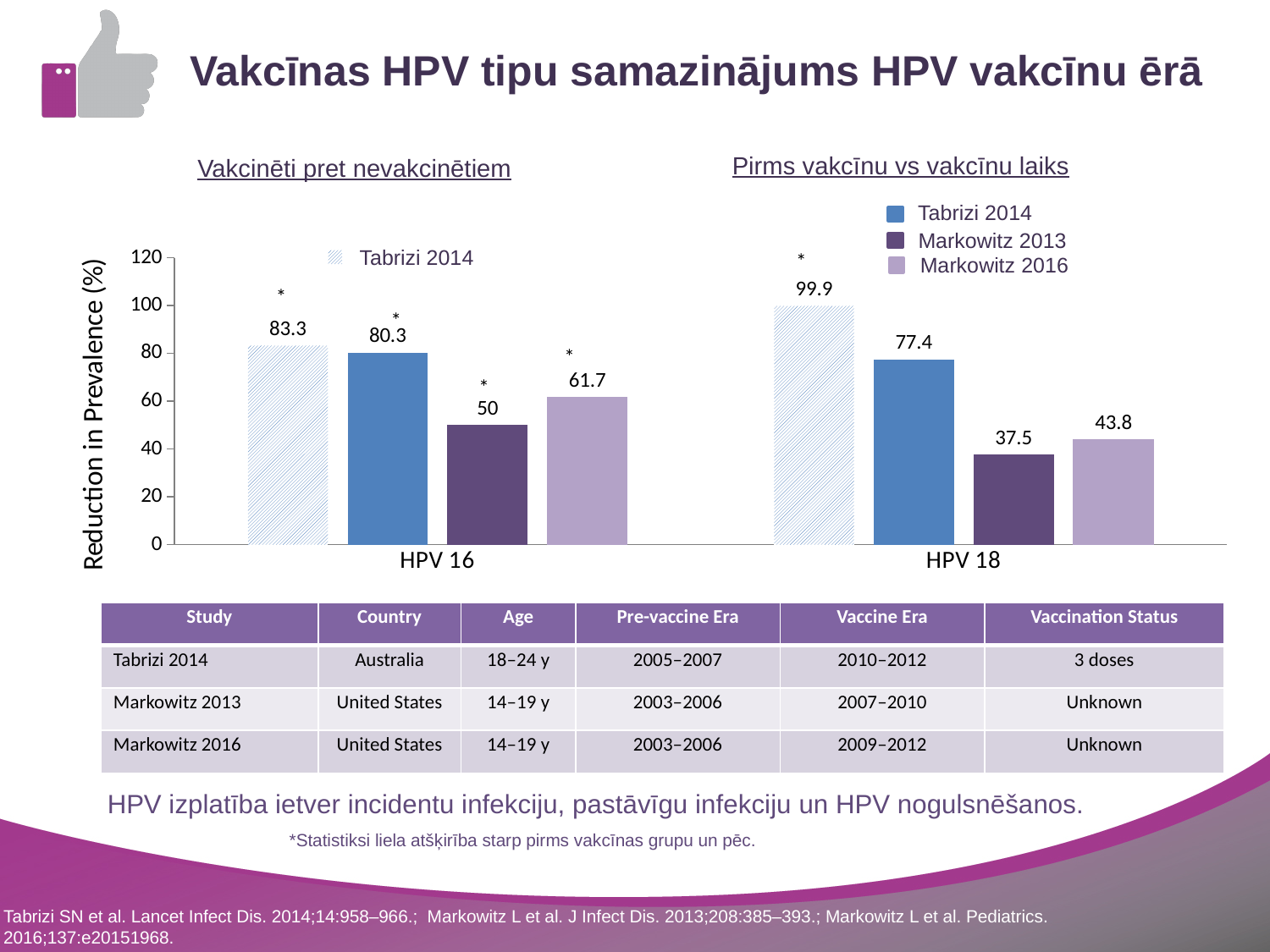
What is the reduction in prevalence for Markowitz 2013 for HPV 16? 50 Which bar is the highest in the HPV 18 group? Tabrizi 2014 (vaccinated vs unvaccinated, hatched bar) What is the label of the y axis? Reduction in Prevalence (%) Which is larger: the Markowitz 2016 value for HPV 16 or for HPV 18? HPV 16 How many HPV type categories are shown on the x axis? 2 What is the value of the solid blue Tabrizi 2014 bar (pre-vaccine vs vaccine era) for HPV 16? 80.3 What is the difference between the Markowitz 2013 values for HPV 16 and HPV 18? 12.5 What is the reduction in prevalence for Markowitz 2016 for HPV 18? 43.8 What is the value of the hatched Tabrizi 2014 bar (vaccinated vs unvaccinated) for HPV 18? 99.9 What is the difference between the Markowitz 2016 and Markowitz 2013 values for HPV 16? 11.7 Which study shows the lowest reduction in prevalence for HPV 18? Markowitz 2013 What kind of chart is shown on the slide? Bar chart